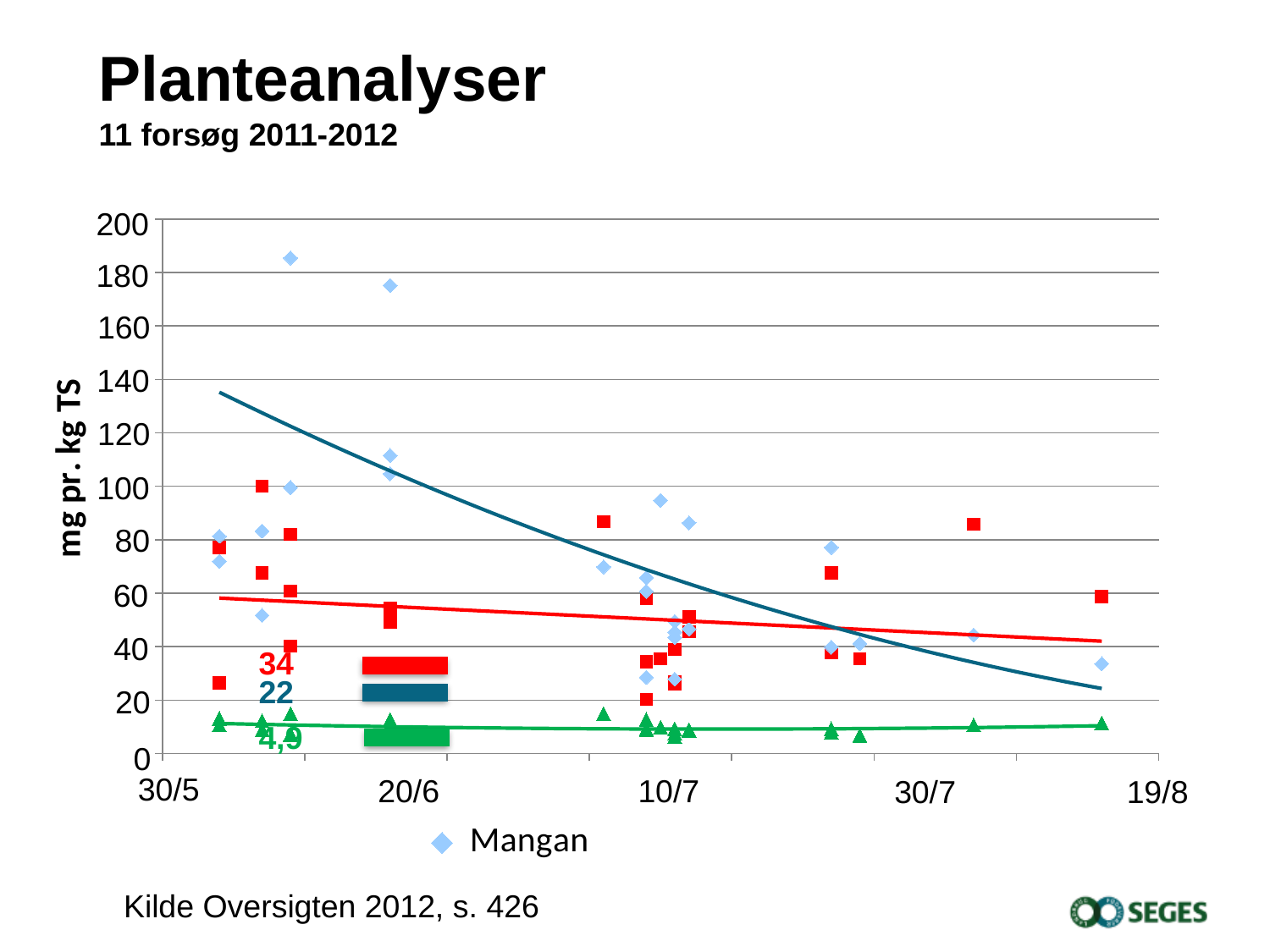
What kind of chart is shown on the slide? scatter chart How many series does the chart's legend list? 1 How many date labels are shown on the x axis? 5 Which series is named in the chart's legend? Mangan Is the highest red square value on the chart greater or less than 120? less What number is printed in green next to the green bar on the chart? 4,9 Is the highest Mangan (blue diamond) value on the chart greater or less than 180? greater Are all the green triangle values on the chart greater or less than 20? less What is the label of the vertical axis? mg pr. kg TS Does the dark blue trend line for Mangan rise or fall from left to right along the x axis? fall Which is larger at the left end of the chart: the dark blue trend line or the red trend line? the dark blue trend line What is the maximum value shown on the vertical axis? 200